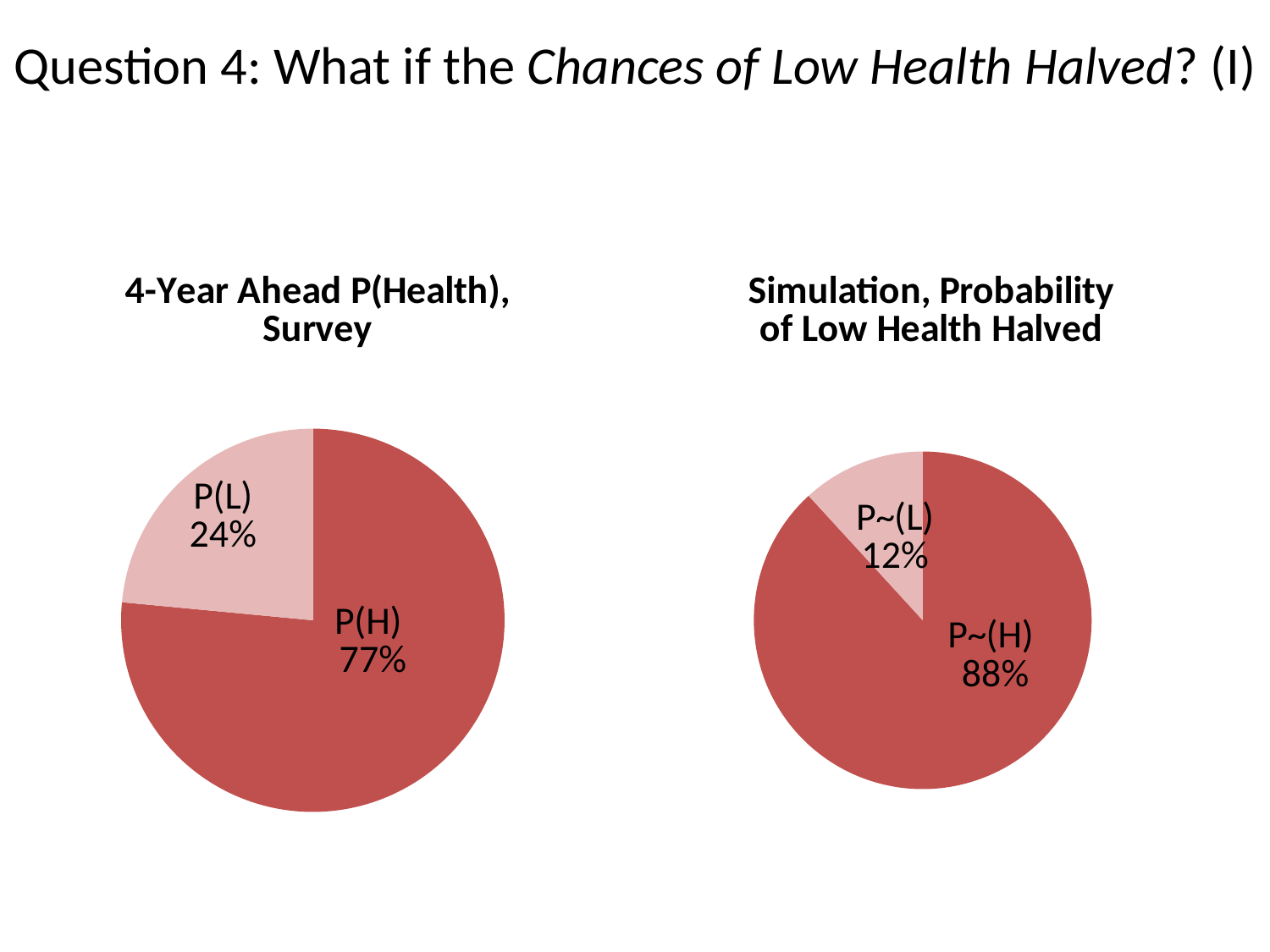
Which is larger: P(L) in the left chart or P~(L) in the right chart? P(L) In the 'Simulation, Probability of Low Health Halved' chart, which slice is the smallest? P~(L) In the 'Simulation, Probability of Low Health Halved' chart, what is the value for P~(H)? 88% In the '4-Year Ahead P(Health), Survey' chart, what is the value for P(L)? 24% What kind of chart is the 'Simulation, Probability of Low Health Halved' chart? Pie chart What is the difference between P(H) and P(L) in the '4-Year Ahead P(Health), Survey' chart? 53% In the '4-Year Ahead P(Health), Survey' chart, what is the value for P(H)? 77% What is the difference between P~(H) and P~(L) in the 'Simulation, Probability of Low Health Halved' chart? 76% In the 'Simulation, Probability of Low Health Halved' chart, what is the value for P~(L)? 12% In the '4-Year Ahead P(Health), Survey' chart, which slice is the largest? P(H) How many slices does the '4-Year Ahead P(Health), Survey' chart have? 2 How many charts are shown on the slide? 2